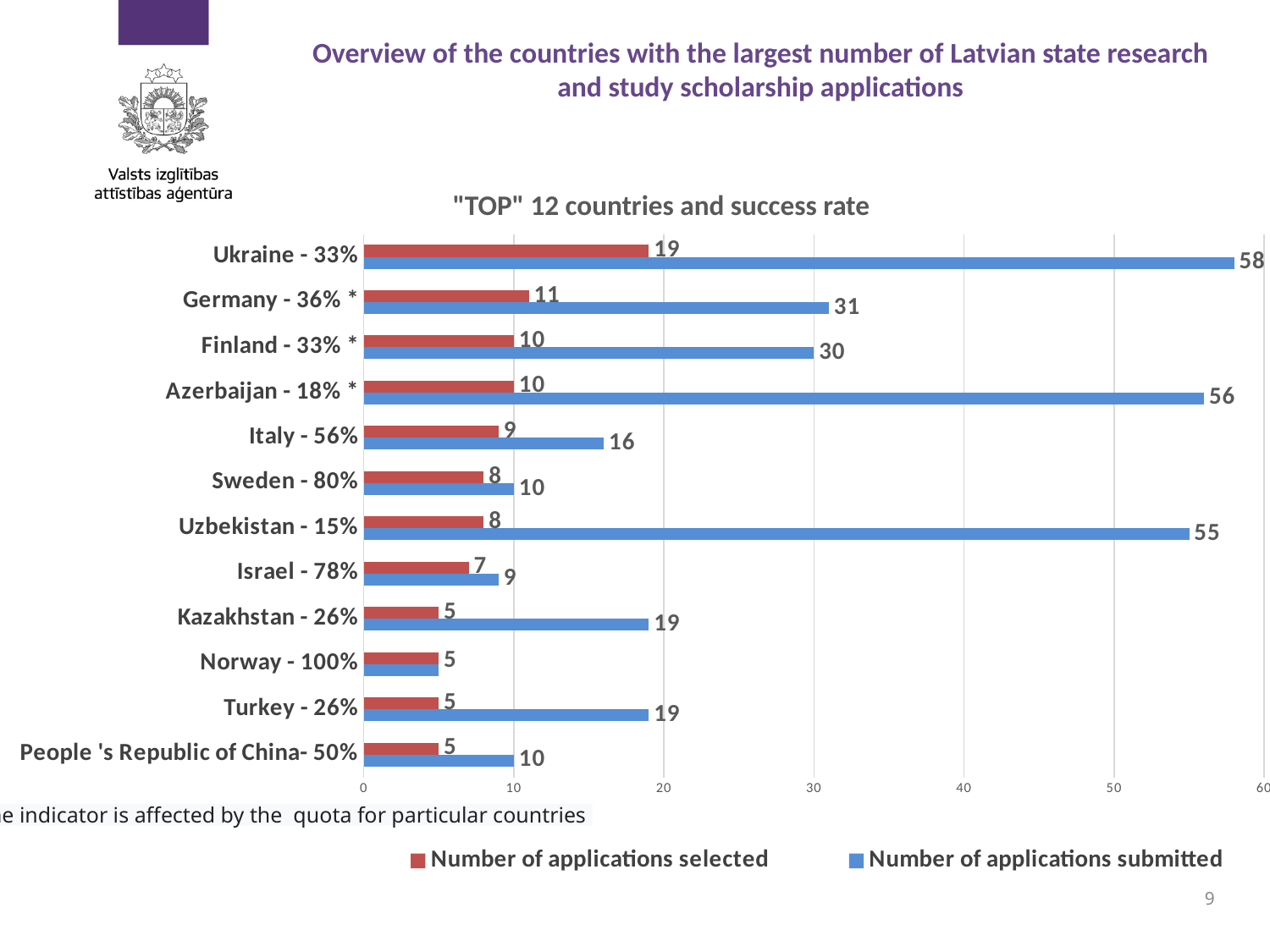
What is the number of applications selected for Germany - 36% *? 11 What is the difference between the number of applications submitted and selected for Azerbaijan - 18% *? 46 What is the number of applications submitted for Uzbekistan - 15%? 55 Which country has the highest number of applications selected? Ukraine - 33% How many countries are shown on the chart? 12 What is the number of applications submitted for Ukraine - 33%? 58 What kind of chart is shown on the slide? bar chart How many series does the legend list? 2 Is the number of applications submitted for Finland - 33% * greater or less than 20? greater Which is larger: the number of applications submitted for Italy - 56% or for Kazakhstan - 26%? Kazakhstan - 26% What is the title of the chart? "TOP" 12 countries and success rate Which country has the highest number of applications submitted? Ukraine - 33%